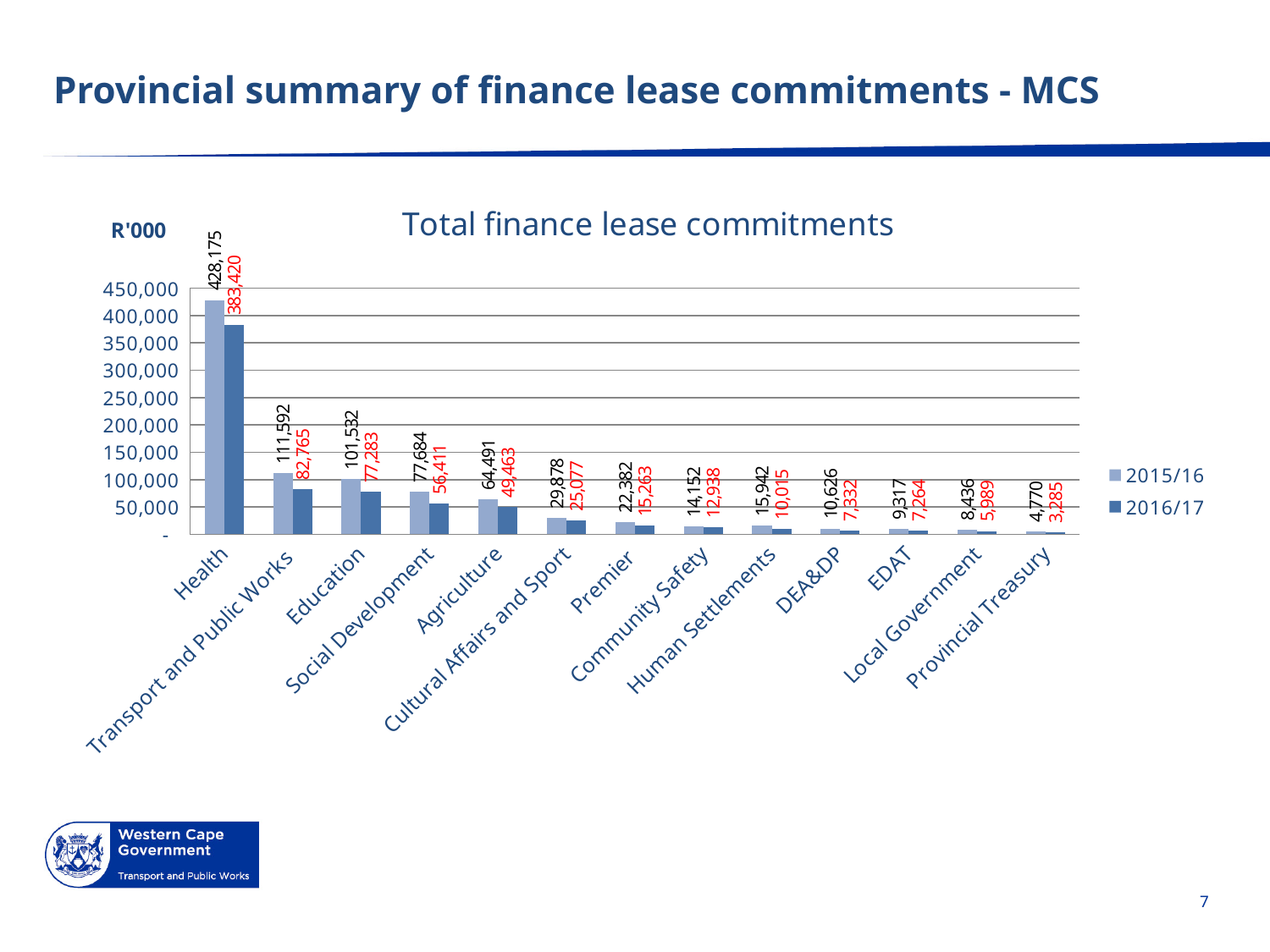
What kind of chart is shown on the slide? Bar chart How many departments are shown on the x axis? 13 Which is larger: the 2015/16 value for Transport and Public Works or the 2015/16 value for Education? Transport and Public Works What is the 2016/17 value for Provincial Treasury? 3,285 What is the difference between the 2015/16 and 2016/17 values for Health? 44,755 What is the 2015/16 finance lease commitment for Health? 428,175 How many series does the legend list? 2 Which department has the lowest finance lease commitment in 2016/17? Provincial Treasury What unit is indicated at the top left of the chart's value axis? R'000 Which department has the highest finance lease commitment in 2015/16? Health What is the 2016/17 finance lease commitment for Education? 77,283 What is the 2015/16 value for Human Settlements? 15,942